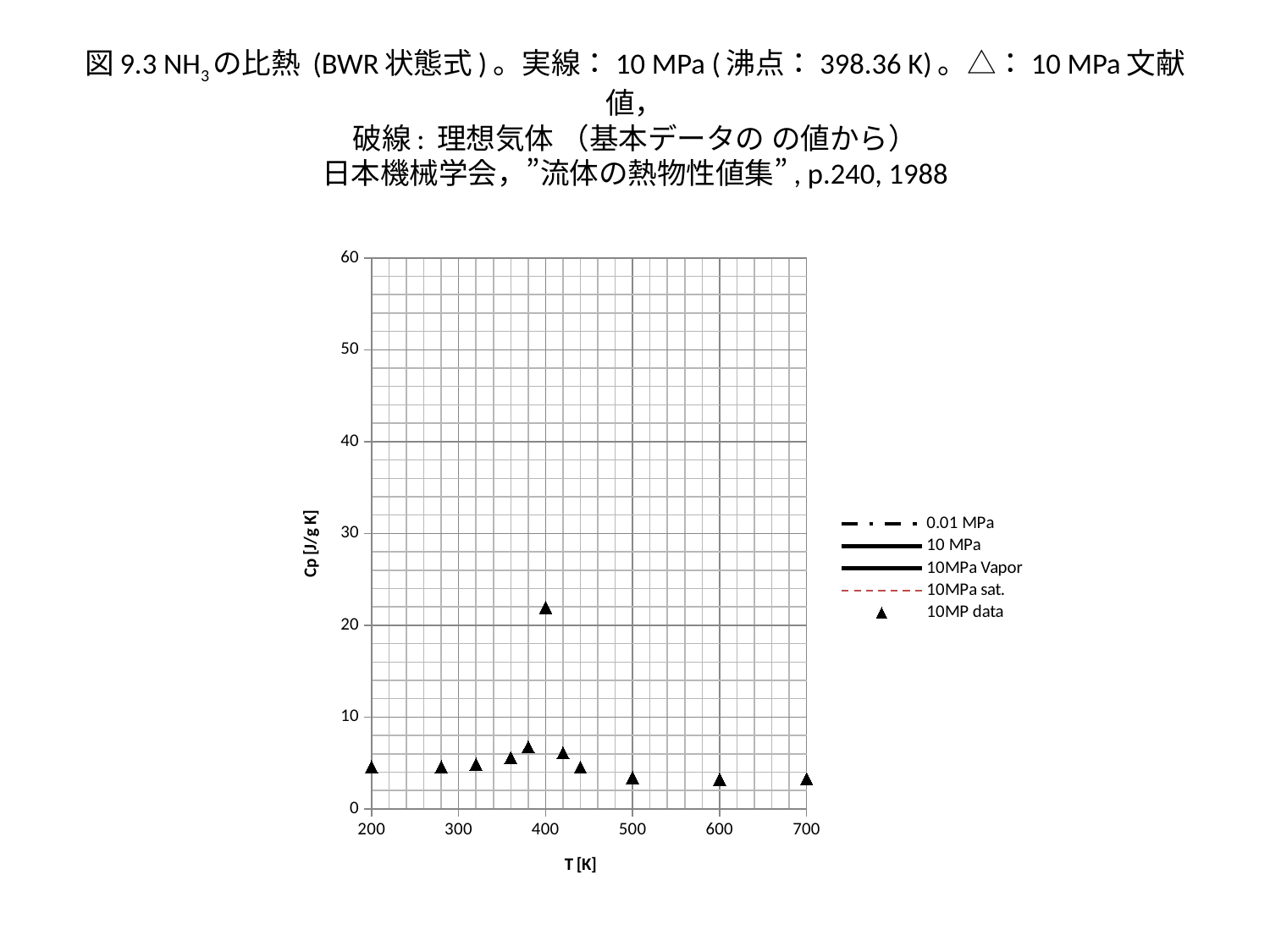
Is the Cp value of the 10MP data point at 700 K greater or less than 10? less Is the Cp value of the 10MP data point at 400 K greater or less than 20? greater At which temperature does the 10MP data series reach its highest Cp value? 400 What is the maximum value shown on the y axis? 60 What is the label of the x axis? T [K] Which 10MP data point has a larger Cp value, the one at 380 K or the one at 200 K? 380 K Is the Cp value of the 10MP data point at 200 K greater or less than 10? less How many series does the legend list? 5 What is the label of the y axis? Cp [J/g K] What kind of chart is shown on the slide? scatter chart How many data points are plotted for the 10MP data series? 11 Which 10MP data point has a larger Cp value, the one at 400 K or the one at 700 K? 400 K